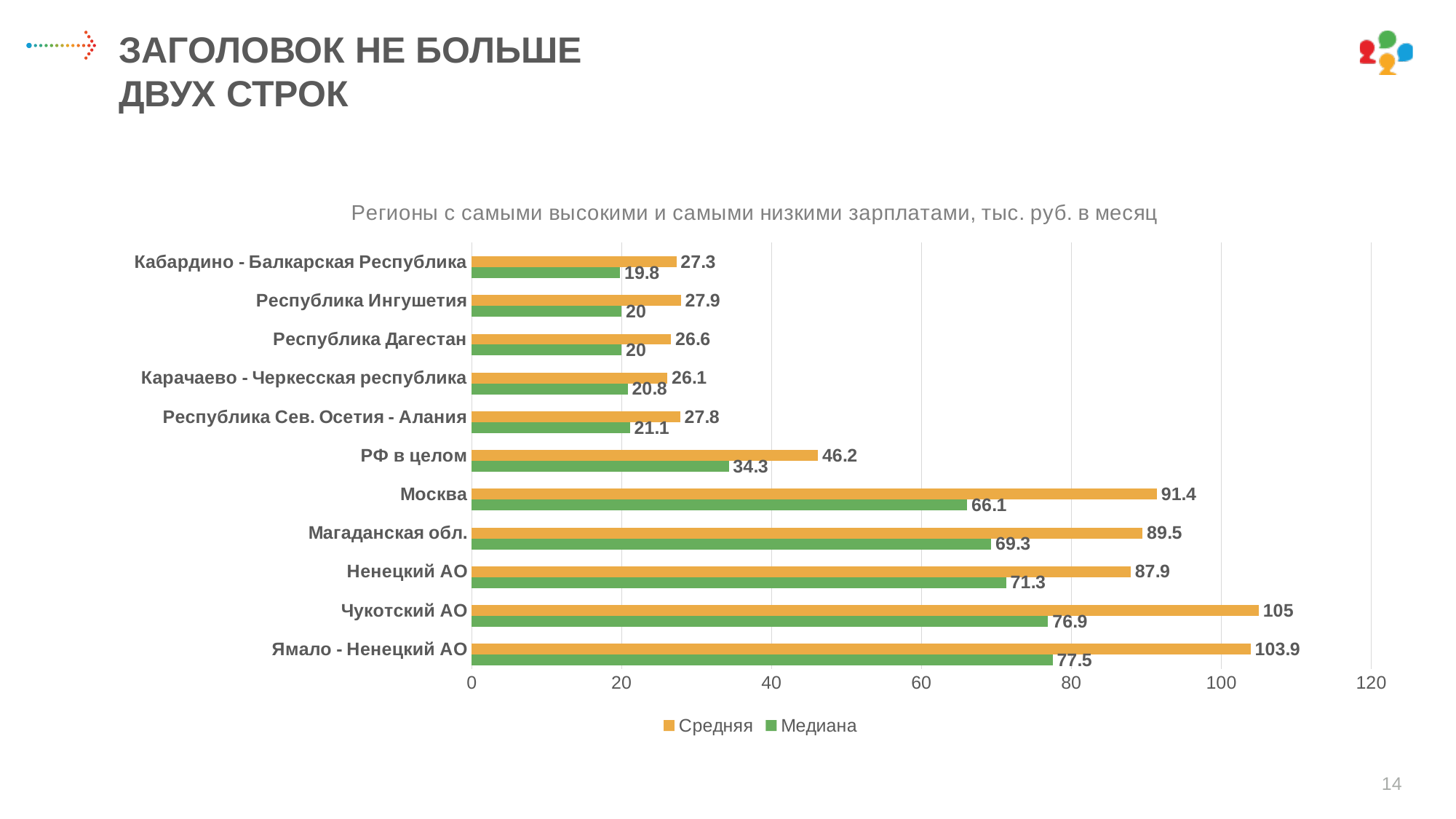
What is the Средняя value for Москва? 91.4 What is the Медиана value for РФ в целом? 34.3 Is the Средняя value for Чукотский АО greater or less than 100? greater Which region has the lowest Медиана value? Кабардино - Балкарская Республика What is the difference between the Средняя and Медиана values for Магаданская обл.? 20.2 What is the Медиана value for Ямало - Ненецкий АО? 77.5 How many regions (categories) are shown on the chart? 11 Which is larger: the Средняя value for Ненецкий АО or the Средняя value for Москва? Москва How many series does the legend list? 2 What kind of chart is shown on the slide? bar chart What is the title of the chart? Регионы с самыми высокими и самыми низкими зарплатами, тыс. руб. в месяц Which region has the highest Средняя value? Чукотский АО